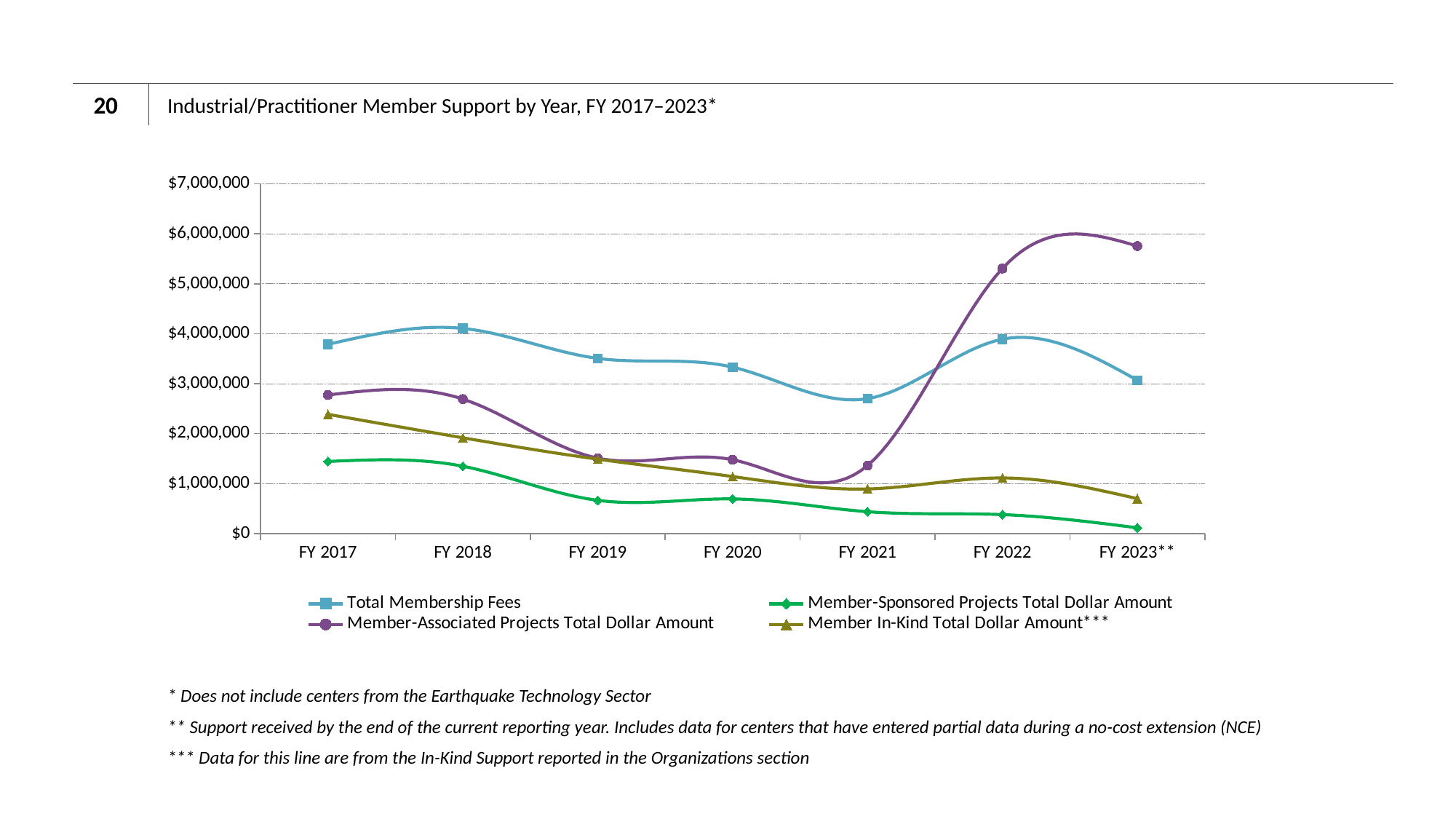
How many fiscal years are plotted along the x axis? 7 In which fiscal year is Member-Associated Projects Total Dollar Amount highest? FY 2023 In FY 2023, which is larger: Member-Associated Projects Total Dollar Amount or Total Membership Fees? Member-Associated Projects Total Dollar Amount What is the title of the chart? Industrial/Practitioner Member Support by Year, FY 2017–2023* How many series does the legend list? 4 In which fiscal year is Total Membership Fees highest? FY 2018 In which fiscal year is Total Membership Fees lowest? FY 2021 In which fiscal year is Member-Sponsored Projects Total Dollar Amount lowest? FY 2023 Is the value for Member-Associated Projects Total Dollar Amount in FY 2022 greater or less than $5,000,000? greater Is the value for Member In-Kind Total Dollar Amount in FY 2017 greater or less than $2,000,000? greater Does Member-Sponsored Projects Total Dollar Amount rise or fall from FY 2017 to FY 2023? Fall What kind of chart is shown on the slide? Line chart